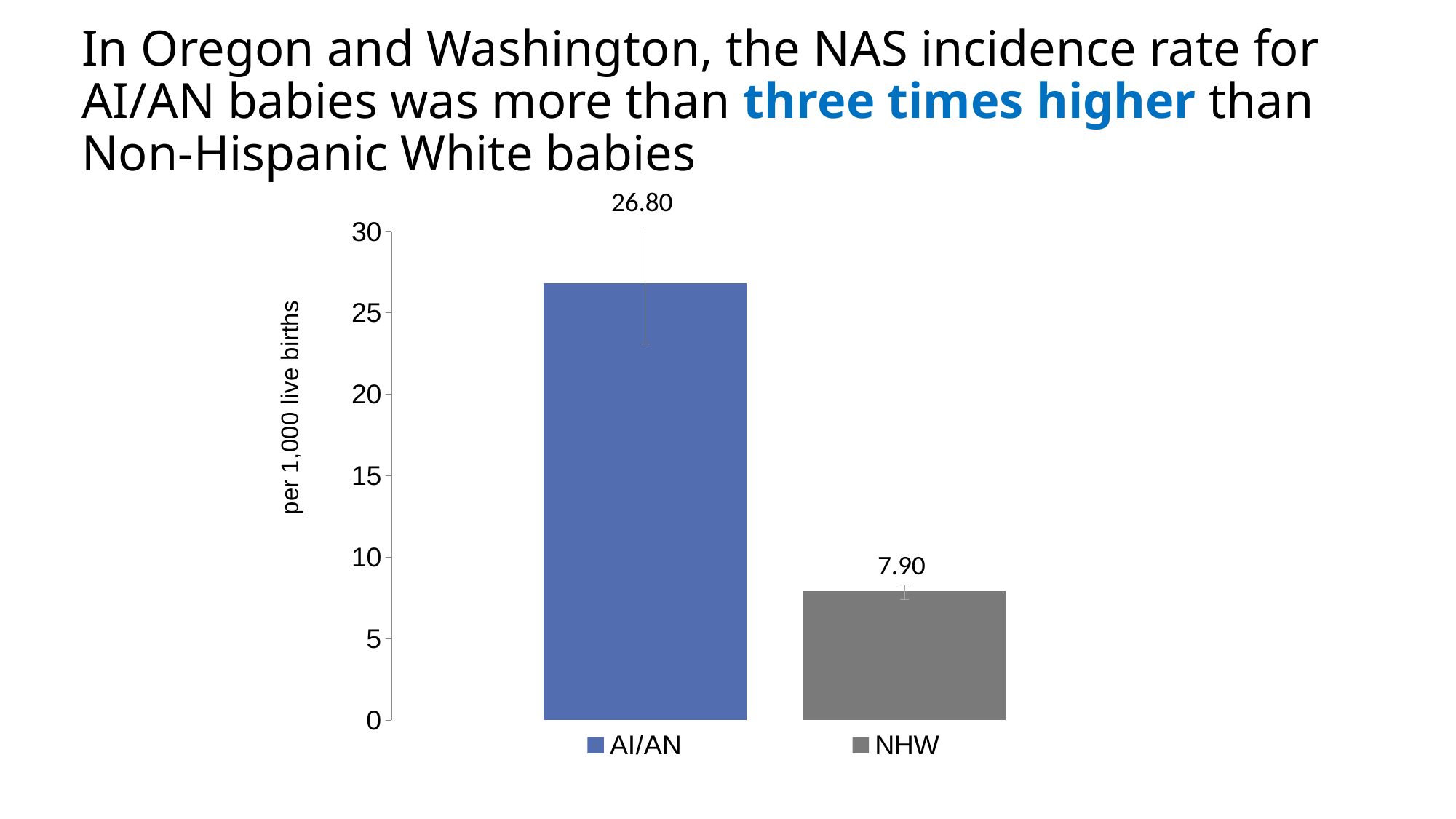
What is the NAS incidence rate per 1,000 live births for AI/AN babies? 26.80 Is the value for NHW greater or less than 10? less What colour is the bar for NHW? Gray Which group has the lowest NAS incidence rate shown on the chart? NHW What kind of chart is shown on the slide? Bar chart Is the value for AI/AN greater or less than 25? greater What is the difference between the AI/AN and NHW NAS incidence rates? 18.90 Which group has the higher NAS incidence rate, AI/AN or NHW? AI/AN How many entries does the legend list? 2 What is the label of the vertical axis? per 1,000 live births How many bars are plotted on the chart? 2 What is the NAS incidence rate per 1,000 live births for NHW babies? 7.90